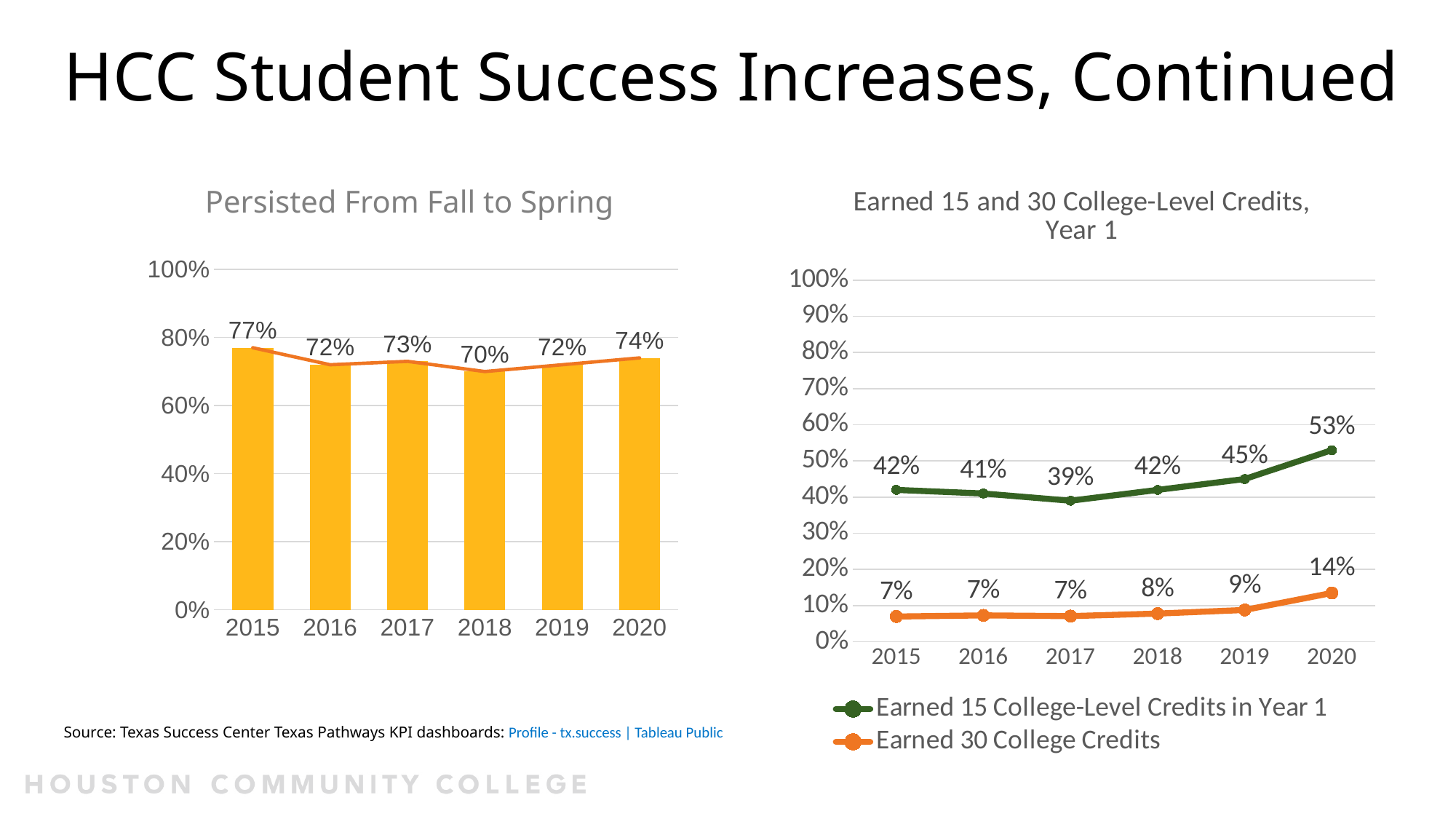
In the 'Earned 15 and 30 College-Level Credits, Year 1' chart, does the 'Earned 30 College Credits' series rise or fall from 2017 to 2020? Rise In the 'Persisted From Fall to Spring' chart, which year has the highest value? 2015 In the 'Earned 15 and 30 College-Level Credits, Year 1' chart, what is the value for 'Earned 30 College Credits' in 2019? 9% In the 'Persisted From Fall to Spring' chart, what is the difference between the 2015 value and the 2018 value? 7 percentage points What kind of chart is 'Persisted From Fall to Spring'? Bar chart In the 'Persisted From Fall to Spring' chart, how many years are shown on the x axis? 6 In the 'Persisted From Fall to Spring' chart, which year has the lowest value? 2018 In the 'Earned 15 and 30 College-Level Credits, Year 1' chart, what is the value for 'Earned 15 College-Level Credits in Year 1' in 2020? 53% In the 'Earned 15 and 30 College-Level Credits, Year 1' chart, which year has the lowest value for 'Earned 15 College-Level Credits in Year 1'? 2017 In the 'Earned 15 and 30 College-Level Credits, Year 1' chart, what is the difference between the two series in 2020? 39 percentage points In the 'Earned 15 and 30 College-Level Credits, Year 1' chart, how many series does the legend list? 2 In the 'Persisted From Fall to Spring' chart, what is the value for 2015? 77%